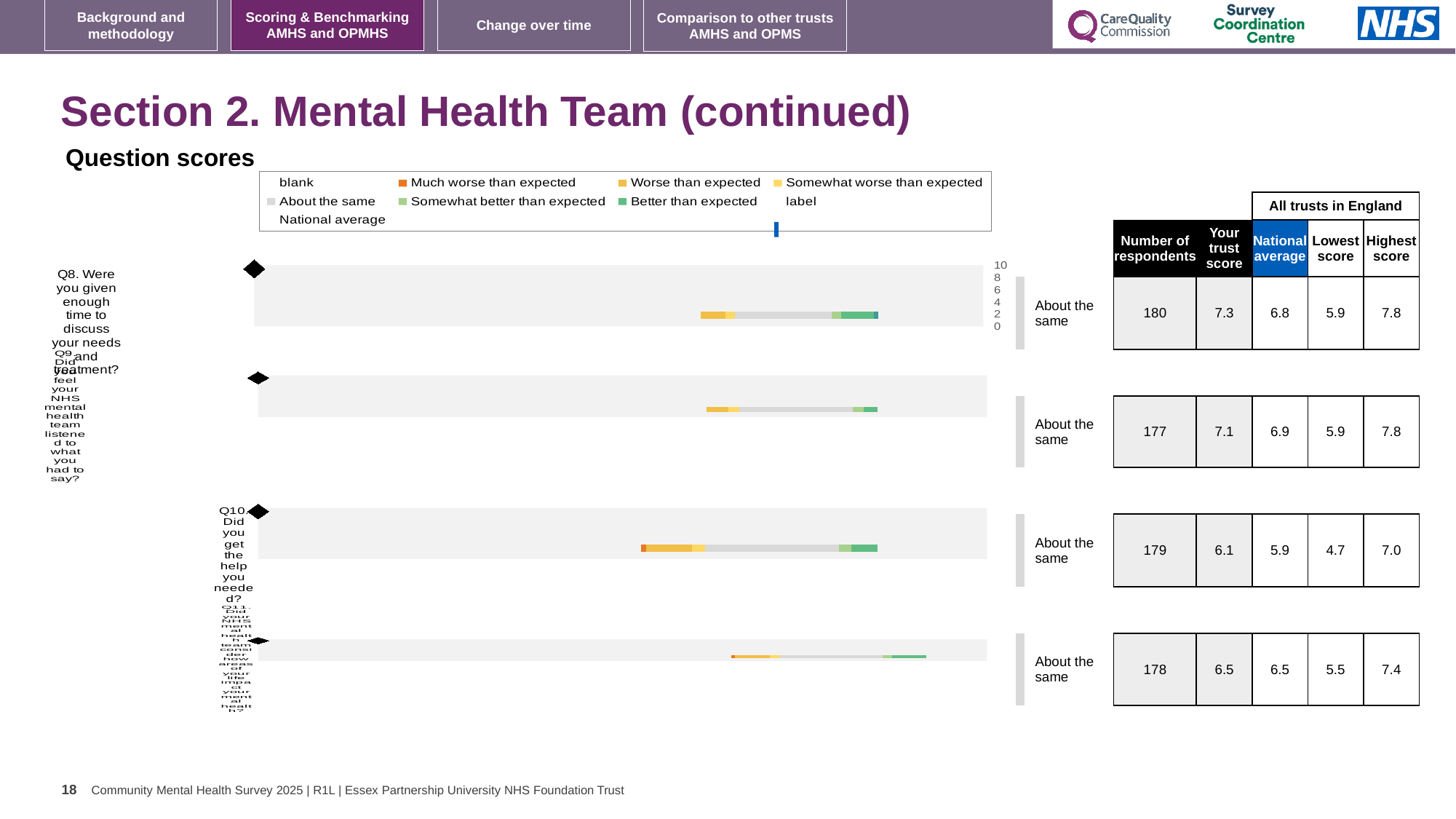
What comparison label is printed to the right of each of the four question bars? About the same What kind of chart is used to show the question scores for Q8 to Q11? bar chart For the Q8 chart row, how many respondents are listed? 180 How many question bar charts are shown on the slide? 4 For the Q10 chart row, what is the national average score? 5.9 Which question row has the highest 'Your trust score'? Q8 For the Q11 chart row, what is the lowest score among all trusts in England? 5.5 In the legend, what colour represents 'Better than expected'? green For the Q8 chart row, what is the 'Your trust score' value in the table? 7.3 For the Q8 row, what is the difference between 'Your trust score' and the national average? 0.5 Which question row has the lowest 'Your trust score'? Q10 For the Q9 row, which is larger: 'Your trust score' or the national average? Your trust score